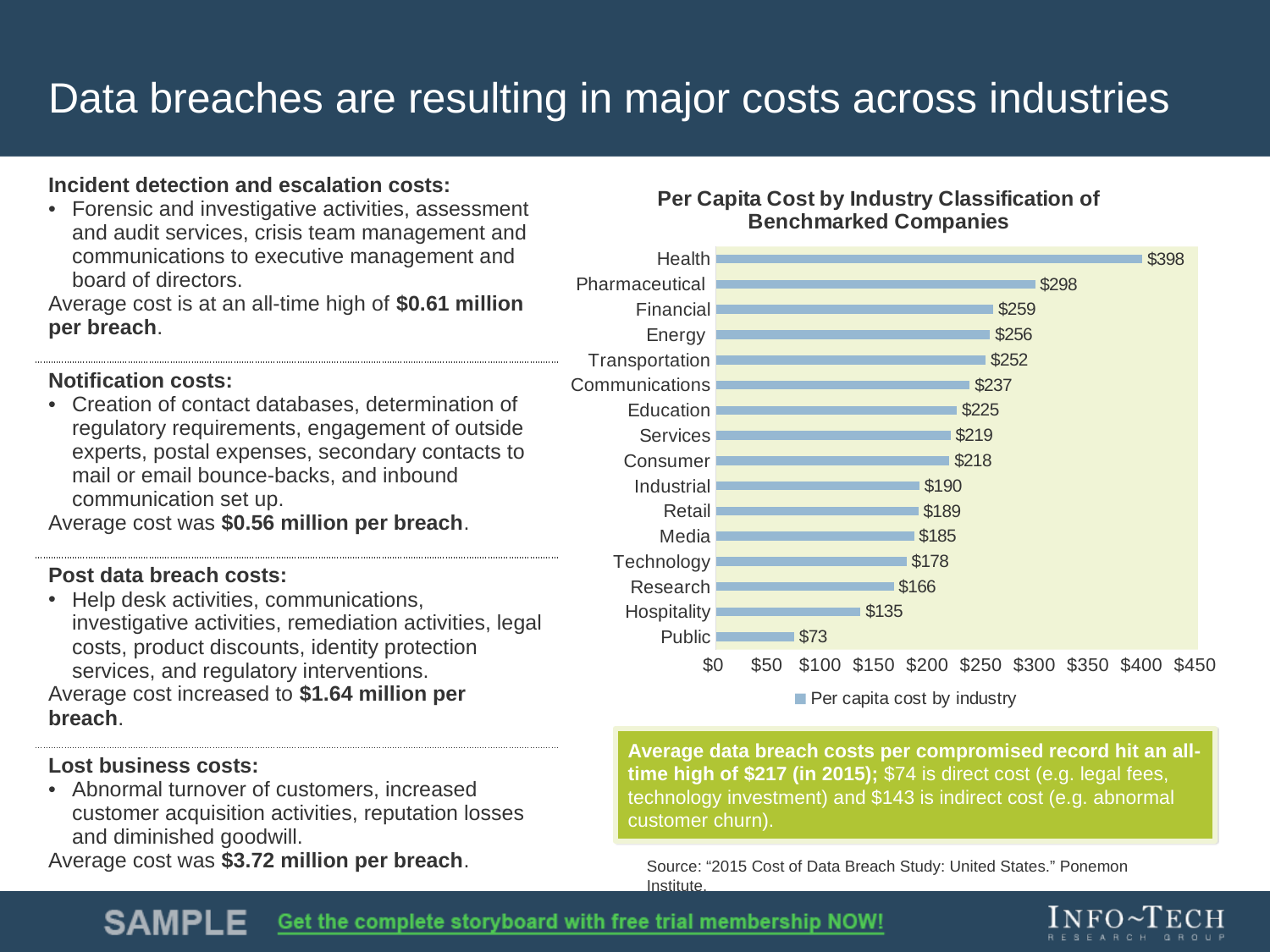
How many series does the legend list? 1 What is the title of the chart? Per Capita Cost by Industry Classification of Benchmarked Companies Which industry has the lowest per capita cost? Public Is the per capita cost for Research greater or less than $150? greater What is the difference between the per capita cost for Technology and Public? $105 Which has a higher per capita cost, Energy or Education? Energy Which industry has the highest per capita cost? Health What is the per capita cost for the Hospitality industry? $135 What is the difference between the per capita cost for Health and Pharmaceutical? $100 What is the per capita cost for the Health industry? $398 How many industries are shown in the chart? 16 What kind of chart is shown on the slide? Bar chart